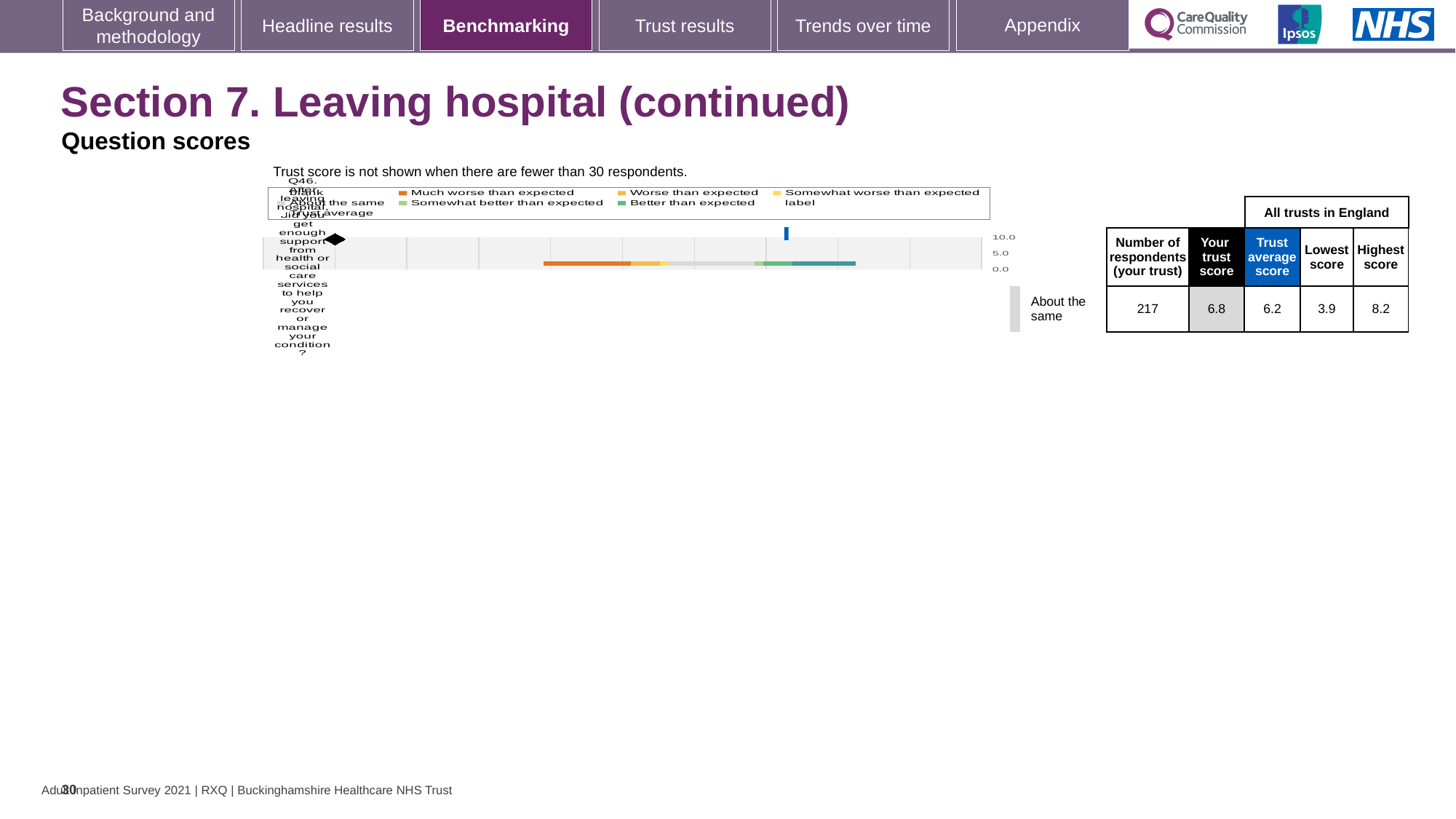
What kind of chart is used to show the Q46 benchmarking result? Bar chart How many respondents from the trust answered Q46? 217 Is the trust score for Q46 greater or less than 5.0 on the chart axis? greater What is the highest score among all trusts in England for Q46? 8.2 What is the trust score for Q46 shown on the chart? 6.8 Which is larger for Q46: the trust's own score or the trust average score? Your trust score (6.8) What is the difference between the highest and lowest scores across all trusts in England for Q46? 4.3 What is the lowest score among all trusts in England for Q46? 3.9 What benchmarking category is the trust's Q46 score assigned to? About the same How many questions are plotted on the chart? 1 What is the difference between the trust's score and the trust average score for Q46? 0.6 What is the trust average score for Q46? 6.2